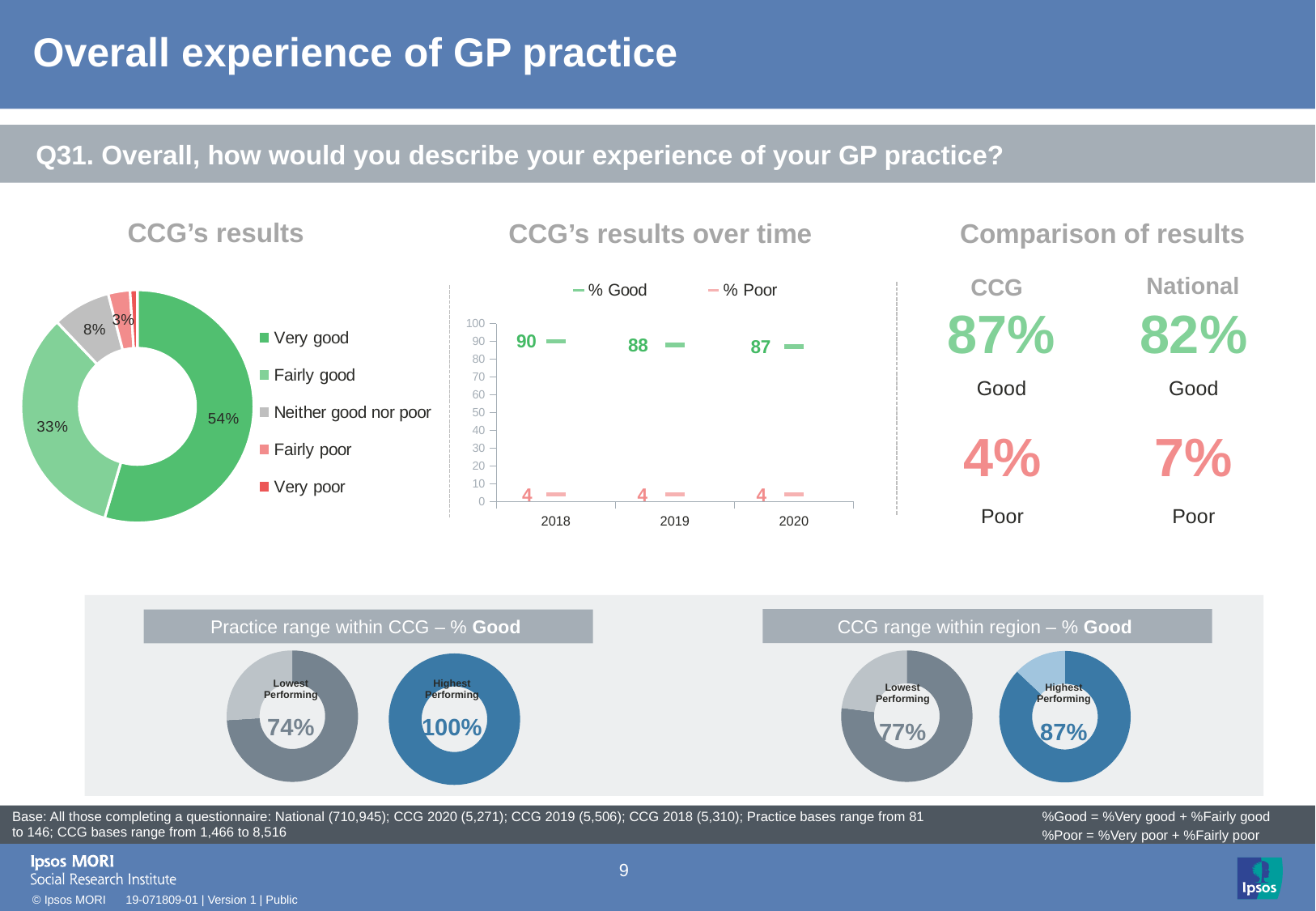
In the 'CCG's results over time' chart, what is the difference between % Good in 2018 and % Good in 2020? 3 In the 'Practice range within CCG – % Good' section, what value is shown for the highest performing practice? 100% In the 'CCG's results' donut chart, what percentage is shown for 'Very good'? 54% In the 'CCG's results' donut chart, what is the difference between the 'Very good' and 'Fairly good' shares? 21 percentage points In the 'CCG's results over time' chart, what is the % Poor value for 2020? 4 In the 'CCG's results over time' chart, how many series does the legend list? 2 In the 'CCG's results' donut chart, which category has the largest share? Very good In the 'CCG's results' donut chart, what percentage is shown for 'Fairly good'? 33% In the 'CCG's results over time' chart, does the % Good series rise or fall from 2018 to 2020? Fall In the 'CCG's results over time' chart, what is the % Good value for 2018? 90 In the 'CCG's results' donut chart, how many categories does the legend list? 5 In the 'CCG range within region – % Good' section, what value is shown for the lowest performing CCG? 77%